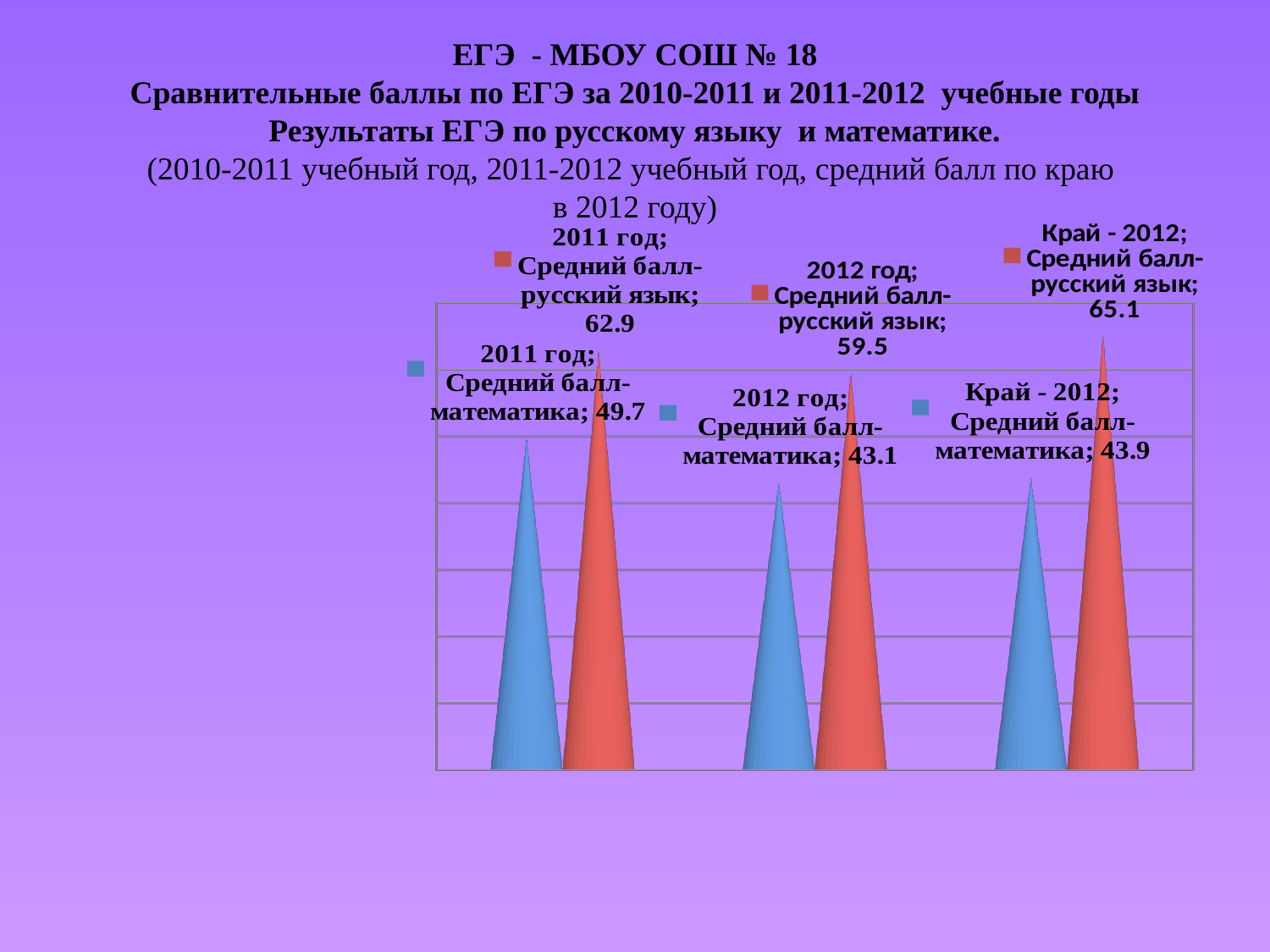
How many data series are plotted on the chart? 2 Which category has the highest average score in Russian language? Край - 2012 How many categories are shown on the chart? 3 What is the average score in Russian language for Край - 2012? 65.1 Which category has the lowest average score in mathematics? 2012 год What is the difference between the mathematics average score for 2011 год and for 2012 год? 6.6 What is the average score in Russian language (Средний балл-русский язык) for 2011 год? 62.9 What kind of chart is shown on the slide? Bar chart What is the average score in mathematics (Средний балл-математика) for 2012 год? 43.1 Which is larger: the mathematics average score for 2011 год or for Край - 2012? 2011 год What is the average score in mathematics for Край - 2012? 43.9 What is the difference between the Russian language average score for 2011 год and for 2012 год? 3.4